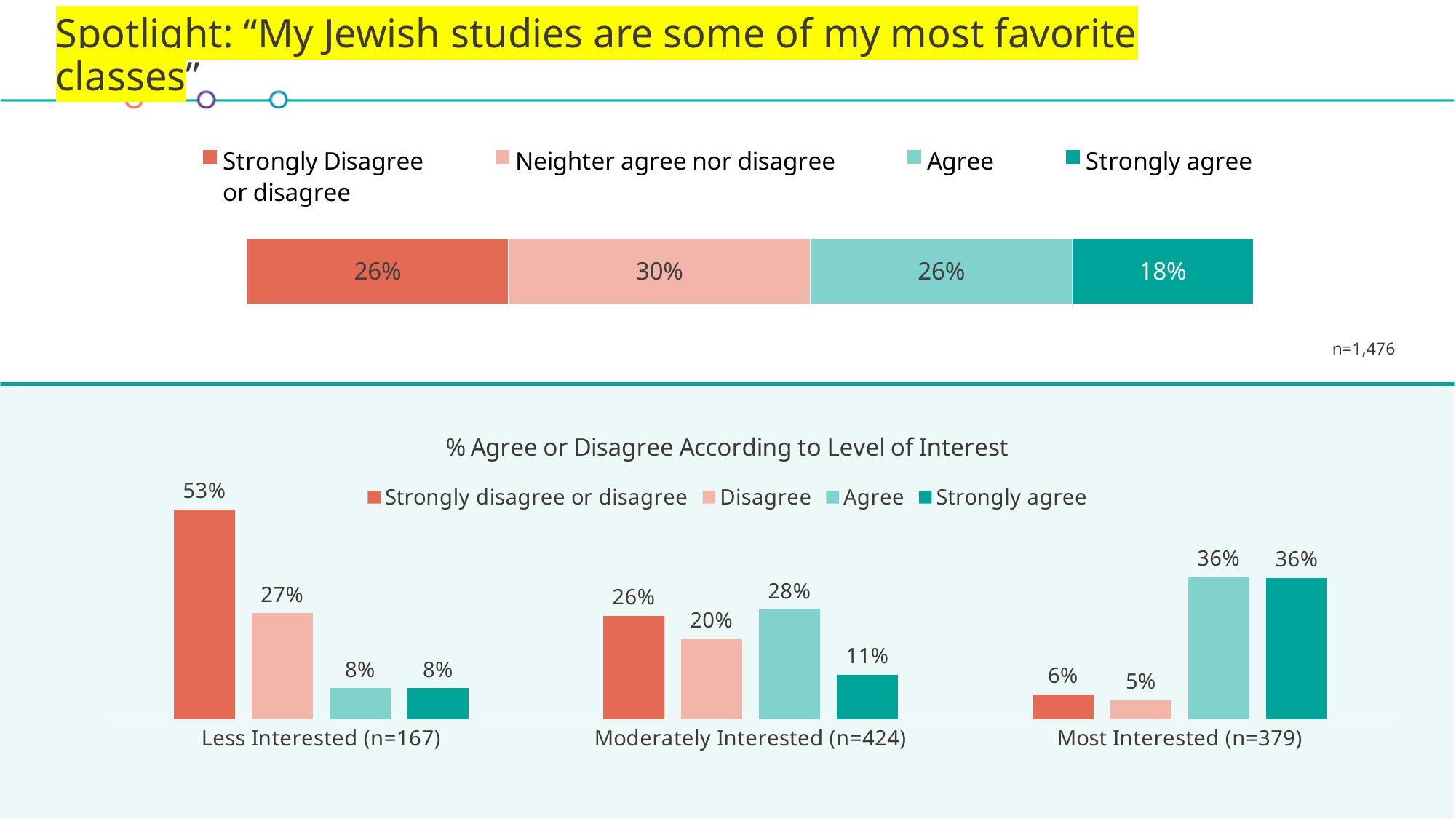
In the chart titled "% Agree or Disagree According to Level of Interest", what is the value for "Strongly disagree or disagree" in the Less Interested (n=167) group? 53% In the top stacked bar chart, how many series does the legend list? 4 In the chart titled "% Agree or Disagree According to Level of Interest", which group has the highest "Strongly disagree or disagree" value? Less Interested (n=167) In the chart titled "% Agree or Disagree According to Level of Interest", what is the value for "Agree" in the Moderately Interested (n=424) group? 28% In the chart titled "% Agree or Disagree According to Level of Interest", how many groups are shown on the x axis? 3 In the top stacked bar chart, which response category has the smallest share? Strongly agree In the chart titled "% Agree or Disagree According to Level of Interest", what is the difference between the "Strongly agree" values for the Most Interested (n=379) and Less Interested (n=167) groups? 28% In the top stacked bar chart, what percentage is shown for "Strongly agree"? 18% What kind of chart is the chart titled "% Agree or Disagree According to Level of Interest"? Bar chart In the chart titled "% Agree or Disagree According to Level of Interest", what is the value for "Strongly agree" in the Most Interested (n=379) group? 36% In the chart titled "% Agree or Disagree According to Level of Interest", which is larger: "Disagree" for Moderately Interested (n=424) or "Disagree" for Most Interested (n=379)? Moderately Interested (n=424) In the top stacked bar chart, what percentage is shown for "Neighter agree nor disagree"? 30%